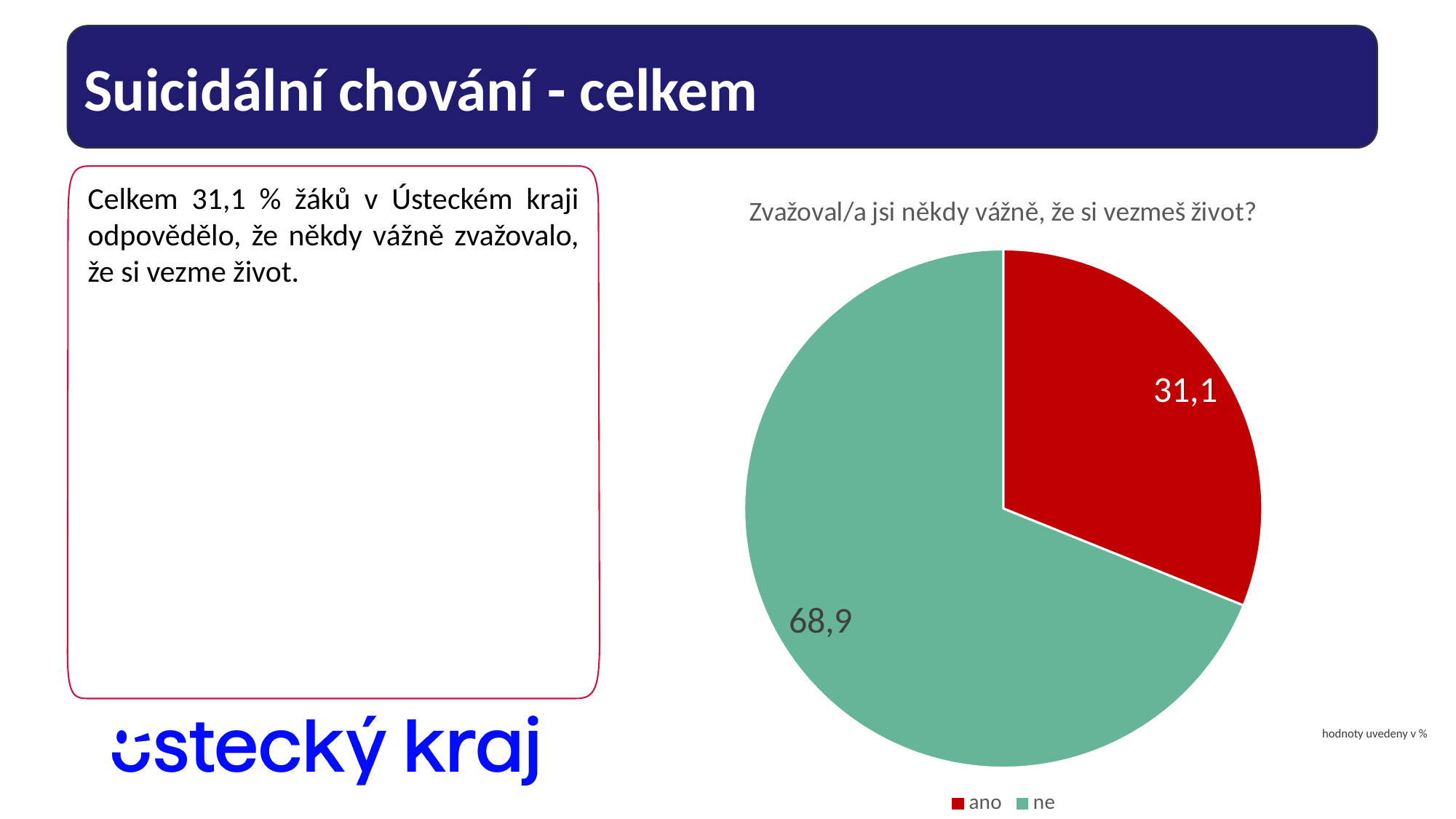
Which slice of the pie chart is the smallest? ano What is the title of the pie chart? Zvažoval/a jsi někdy vážně, že si vezmeš život? What type of chart is shown on the slide? pie chart Which slice of the pie chart is the largest? ne What is the value for "ano" in the pie chart? 31,1 How many entries does the legend of the pie chart list? 2 What is the difference between the values for "ne" and "ano"? 37,8 How many slices does the pie chart have? 2 Which is larger, the value for "ano" or the value for "ne"? ne What share of the pie does the "ano" slice represent? 31,1 % What is the value for "ne" in the pie chart? 68,9 What colour is the "ano" slice in the pie chart? red